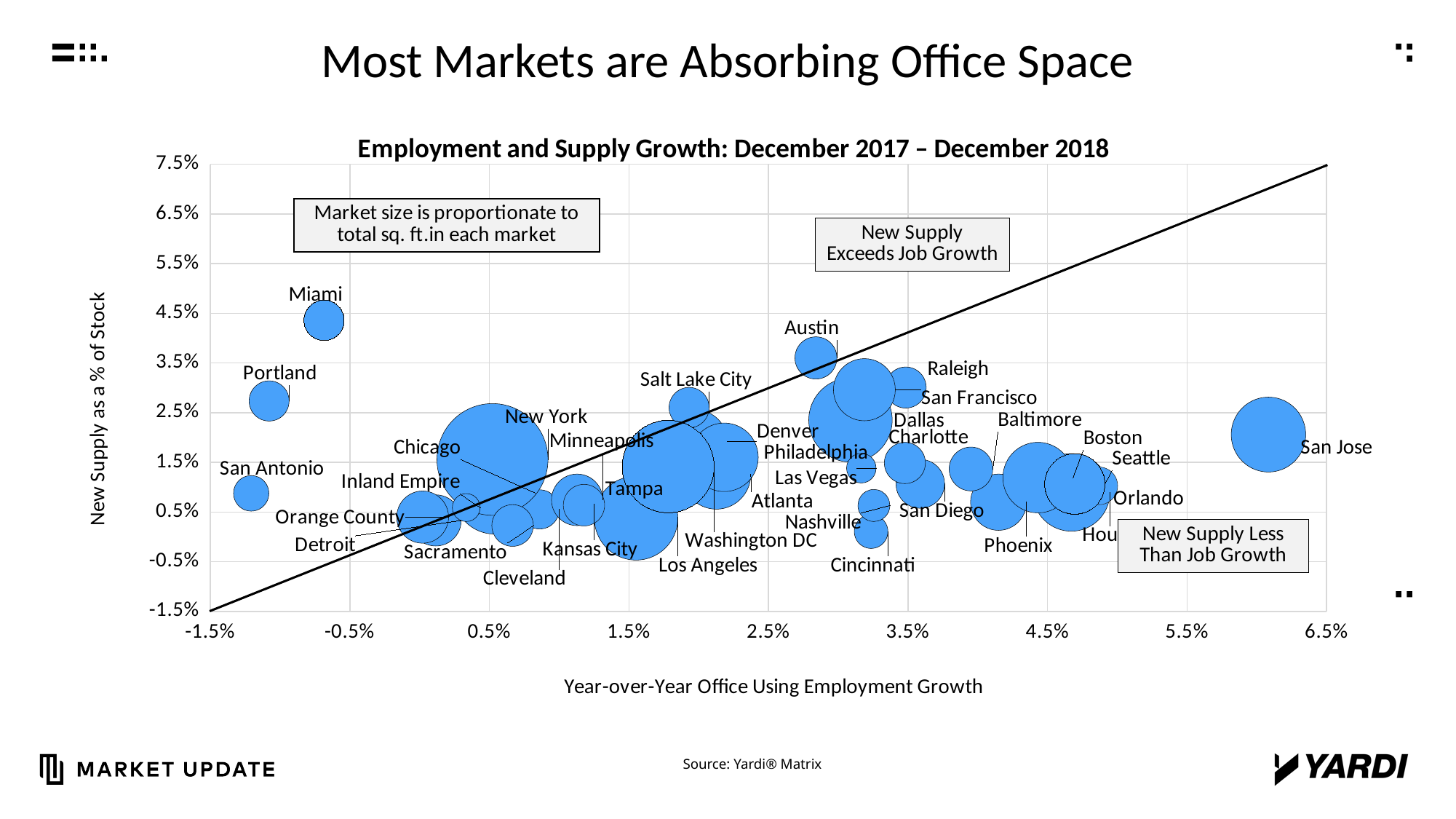
Which market has the highest new supply as a % of stock? Miami Which market has higher year-over-year office using employment growth, San Jose or Portland? San Jose Which market has the highest year-over-year office using employment growth? San Jose Is the new supply as a % of stock for Austin greater or less than 2.5%? greater Is the year-over-year office using employment growth for Miami greater or less than 0.5%? less Which market has higher new supply as a % of stock, Miami or Austin? Miami Is the new supply as a % of stock for San Antonio greater or less than 1.5%? less What does the vertical axis of the chart measure? New Supply as a % of Stock What kind of chart is shown on the slide? Bubble chart What is the title of the chart? Employment and Supply Growth: December 2017 – December 2018